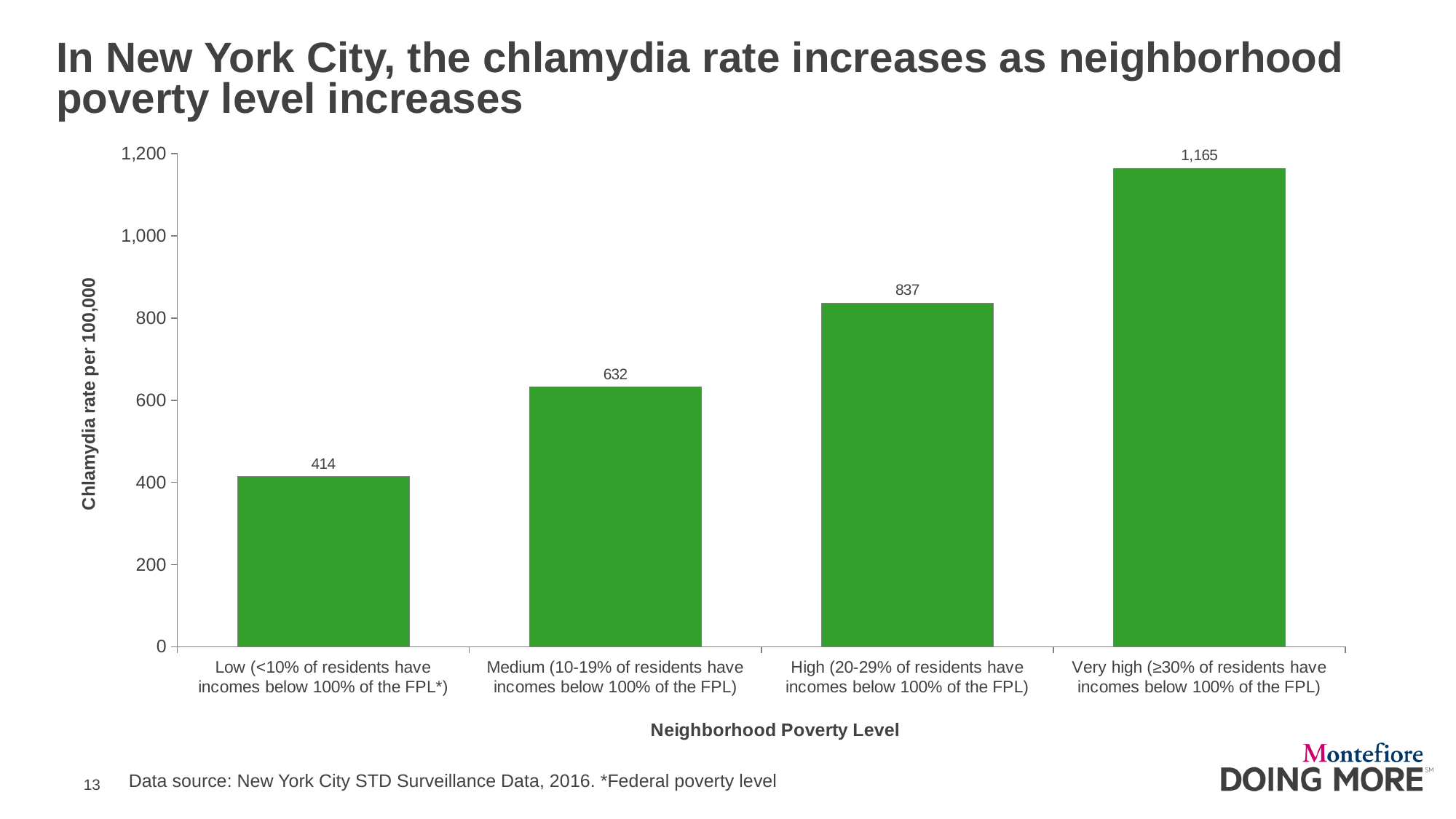
Which neighborhood poverty level has the lowest chlamydia rate? Low What is the difference in chlamydia rate between the High and Medium poverty levels? 205 How many neighborhood poverty level categories are shown in the chart? 4 What kind of chart is shown on the slide? Bar chart Does the chlamydia rate rise or fall as neighborhood poverty level increases along the x axis? Rises What is the difference in chlamydia rate between the Very high and Low poverty levels? 751 What is the chlamydia rate per 100,000 for the Low neighborhood poverty level? 414 What is the chlamydia rate per 100,000 for the Very high neighborhood poverty level? 1,165 Which has a higher chlamydia rate, the Medium or the High poverty level? High What is the chlamydia rate per 100,000 for the Medium neighborhood poverty level? 632 What is the chlamydia rate per 100,000 for the High neighborhood poverty level? 837 Which neighborhood poverty level has the highest chlamydia rate? Very high